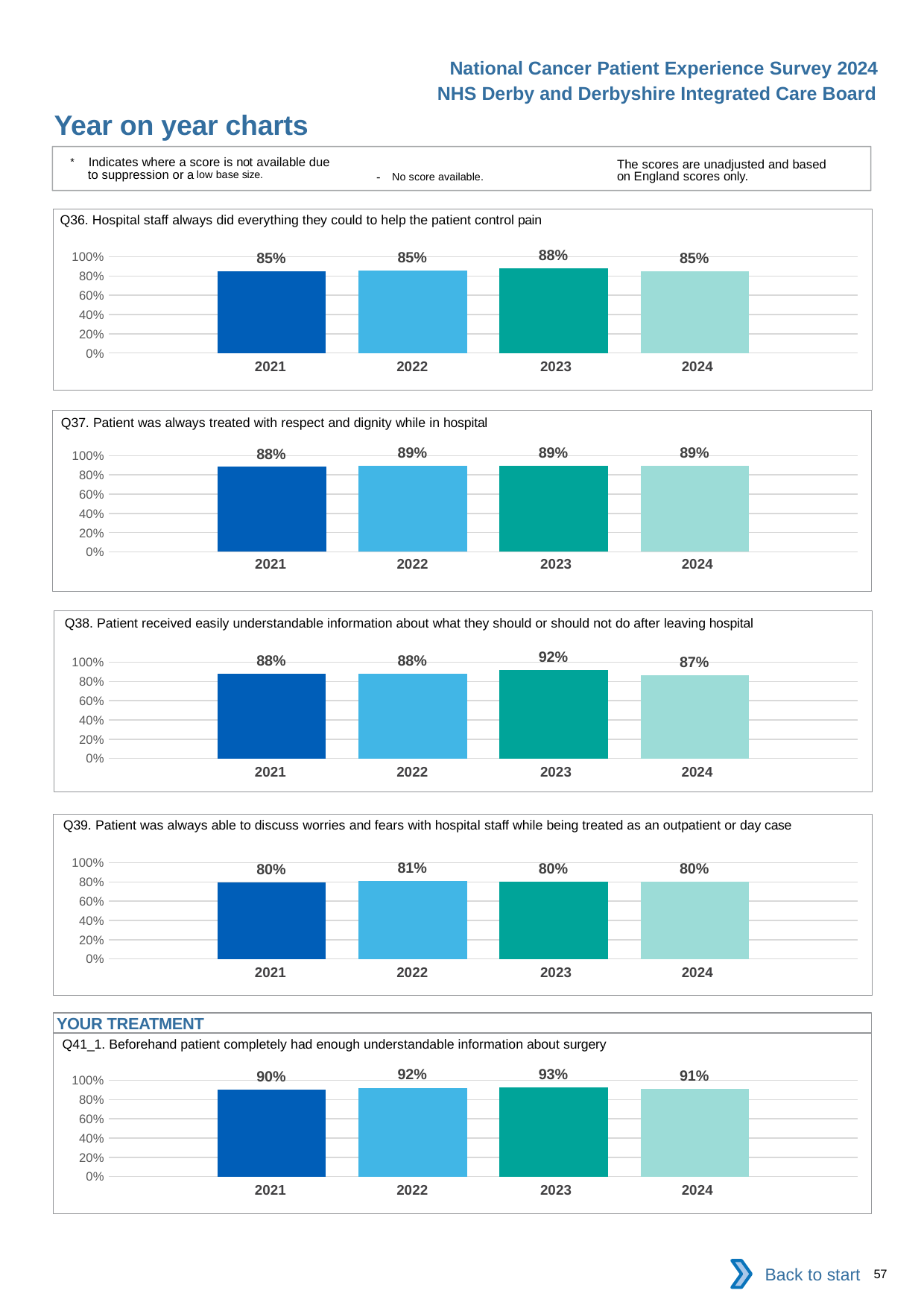
In the Q37 chart (patient treated with respect and dignity), what is the value for 2021? 88% In the Q41_1 chart, which is larger, the value for 2022 or the value for 2024? 2022 In the Q37 chart, which year has the lowest value? 2021 How many years are shown on the x axis of the Q36 chart? 4 In the Q39 chart, is the value for 2024 greater or less than 60%? greater In the Q38 chart (understandable information after leaving hospital), what is the difference between the 2023 and 2024 values? 5 percentage points In the Q41_1 chart (understandable information about surgery), what is the value for 2021? 90% What type of chart is used for Q37? Bar chart In the Q39 chart (discuss worries and fears as an outpatient), what is the value for 2022? 81% In the Q38 chart, which year has the highest value? 2023 In the Q36 chart (hospital staff did everything to help control pain), what is the value for 2023? 88% In the Q36 chart, which year has the highest value? 2023